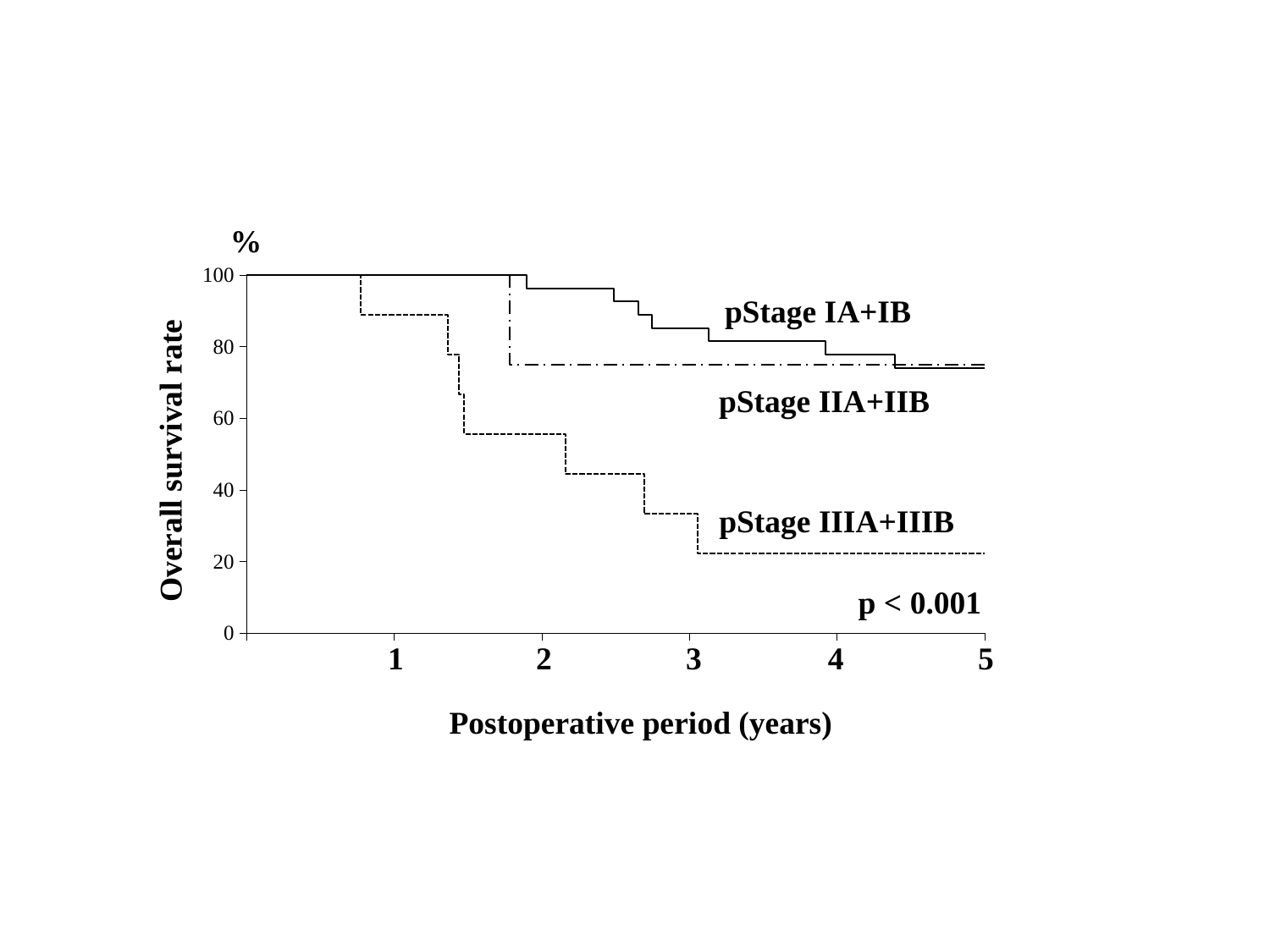
What p-value is shown on the chart? p < 0.001 How many pStage groups (series) are plotted on the chart? 3 Is the overall survival rate for pStage IIIA+IIIB at 5 years greater or less than 40? less Is the overall survival rate for pStage IIIA+IIIB at 2 years greater or less than 40? greater Do the survival curves rise or fall as the postoperative period increases? fall At 5 years, which group has the higher overall survival rate: pStage IA+IB or pStage IIIA+IIIB? pStage IA+IB What kind of chart is shown on the slide? line chart Which group has the lowest overall survival rate at 5 years? pStage IIIA+IIIB Is the overall survival rate for pStage IA+IB at 5 years greater or less than 60? greater What is the overall survival rate for all three groups at the start of the postoperative period (time 0)? 100 Which group has the highest overall survival rate at 2 years? pStage IA+IB